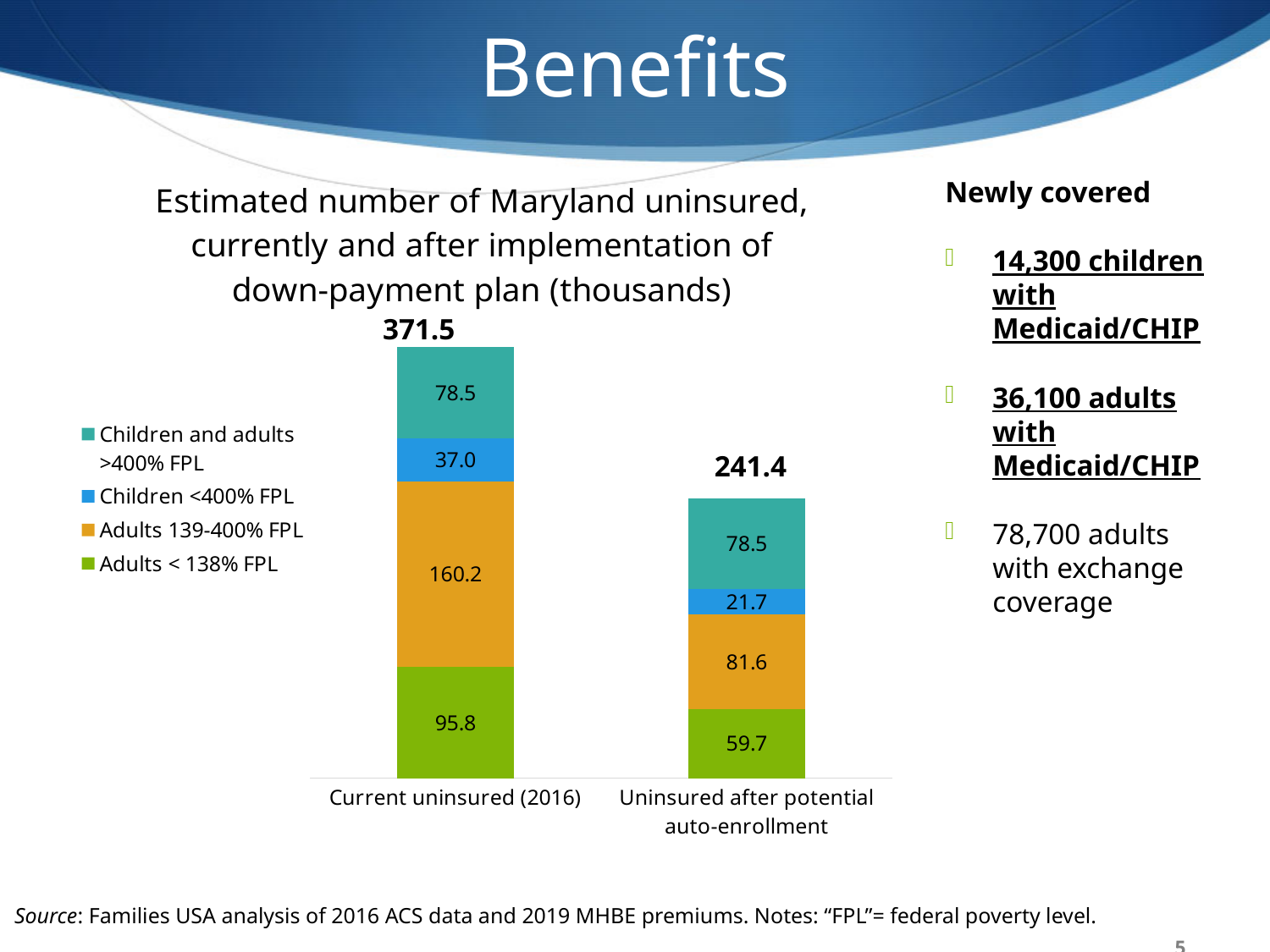
What is the value for Adults < 138% FPL in the Current uninsured (2016) bar? 95.8 What is the total of the Current uninsured (2016) stacked bar? 371.5 Which category has the larger total, Current uninsured (2016) or Uninsured after potential auto-enrollment? Current uninsured (2016) What is the total of the Uninsured after potential auto-enrollment stacked bar? 241.4 What kind of chart is shown on the slide? Stacked bar chart How many series does the legend list? 4 How many categories are shown on the x axis? 2 What is the value for Children and adults >400% FPL in the Uninsured after potential auto-enrollment bar? 78.5 What is the difference between the Adults 139-400% FPL values for Current uninsured (2016) and Uninsured after potential auto-enrollment? 78.6 Which series has the largest value in the Current uninsured (2016) bar? Adults 139-400% FPL What is the value for Children <400% FPL in the Current uninsured (2016) bar? 37.0 What is the value for Adults 139-400% FPL in the Uninsured after potential auto-enrollment bar? 81.6